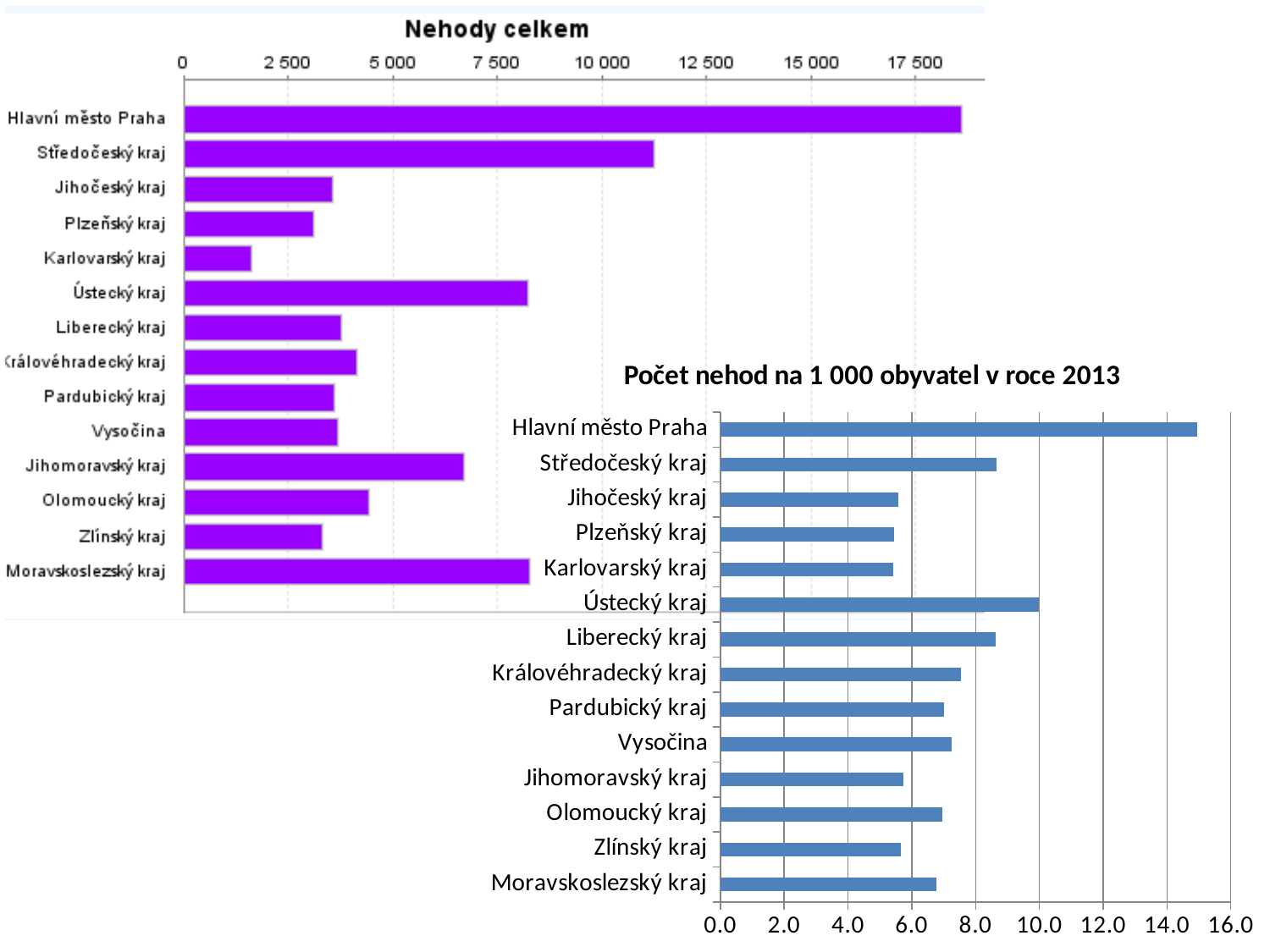
In the 'Počet nehod na 1 000 obyvatel v roce 2013' chart, which region has the highest value? Hlavní město Praha In the 'Nehody celkem' chart, is the value for Jihomoravský kraj greater or less than 7 500? less In the 'Nehody celkem' chart, which is larger, the value for Ústecký kraj or Olomoucký kraj? Ústecký kraj In the 'Nehody celkem' chart, is the value for Středočeský kraj greater or less than 10 000? greater In the 'Počet nehod na 1 000 obyvatel v roce 2013' chart, is the value for Hlavní město Praha greater or less than 14.0? greater In the 'Nehody celkem' chart, which region has the lowest value? Karlovarský kraj What type of chart is 'Počet nehod na 1 000 obyvatel v roce 2013'? bar chart In the 'Nehody celkem' chart, which region has the highest value? Hlavní město Praha How many regions are shown in the 'Nehody celkem' chart? 14 In the 'Počet nehod na 1 000 obyvatel v roce 2013' chart, which is larger, the value for Ústecký kraj or Středočeský kraj? Ústecký kraj